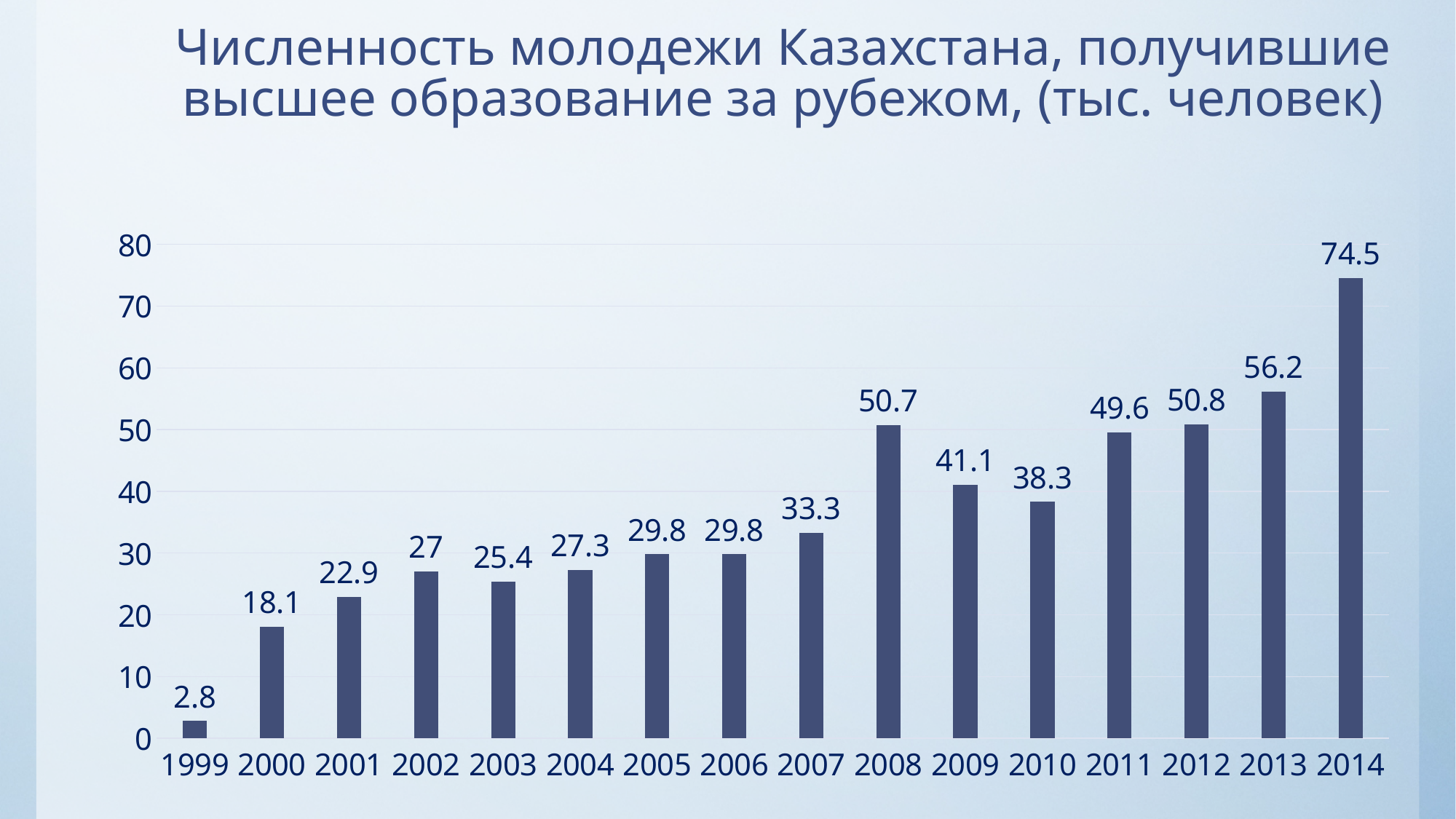
What unit is given in the chart title? тыс. человек Which is larger, the value for 2009 or the value for 2010? 2009 What is the value for 2008? 50.7 Is the value for 2011 greater or less than 40? greater What is the difference between the values for 2014 and 2013? 18.3 Do the values generally rise or fall from 1999 to 2014? rise What kind of chart is this? bar chart How many years are shown on the x axis? 16 What is the value for 1999? 2.8 What is the value for 2012? 50.8 Which year has the highest value? 2014 Which year has the lowest value? 1999